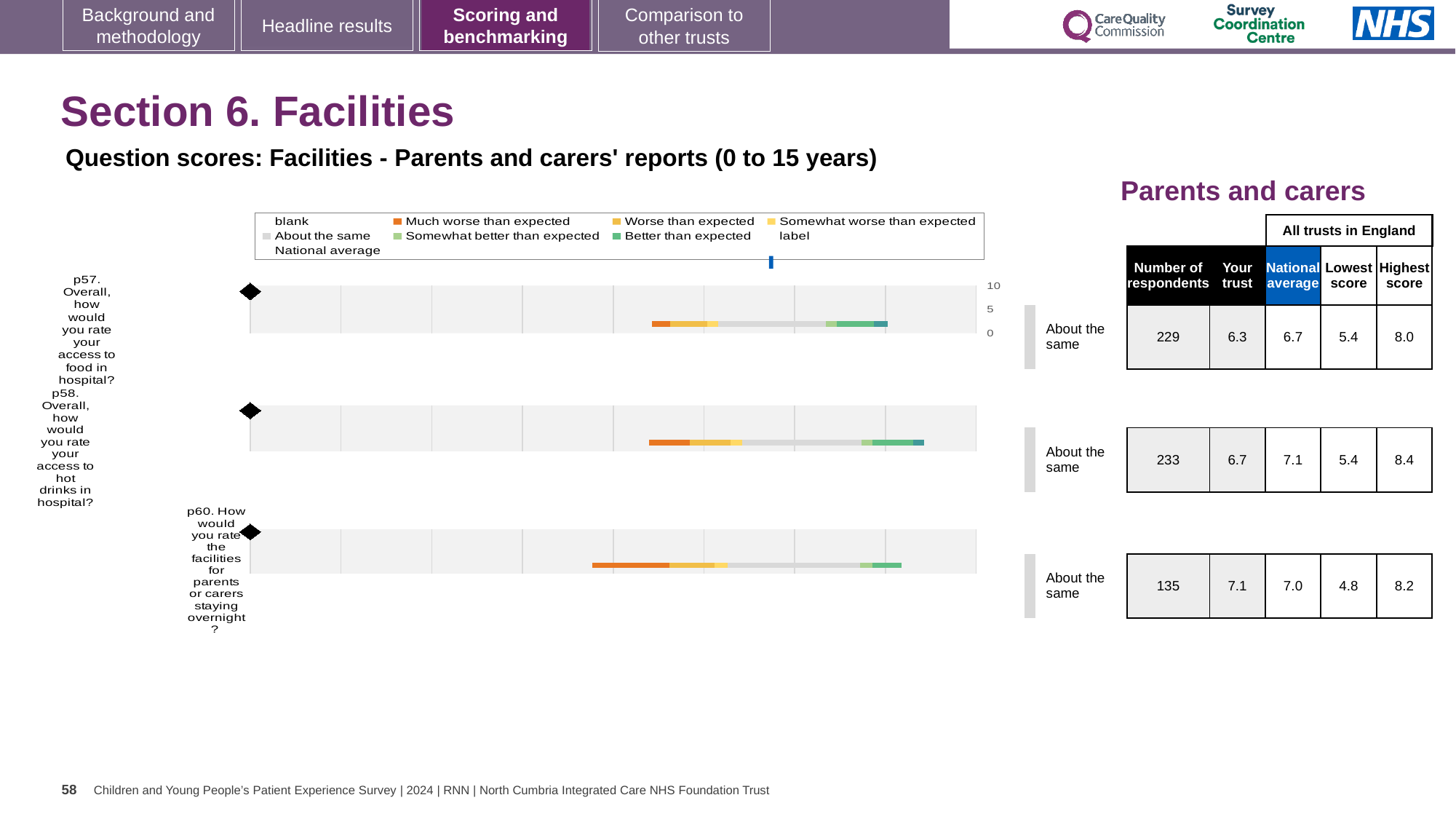
For p60, which is larger: the 'Your trust' score or the national average? Your trust Is the 'Your trust' score for p57 greater or less than 5? greater What is the highest score among all trusts in England for p58? 8.4 Which question has the highest 'Your trust' score? p60 What is the 'Your trust' score for p57 (access to food in hospital)? 6.3 What benchmark category is shown for all three questions in the chart? About the same What is the national average score for p58 (access to hot drinks in hospital)? 7.1 What is the difference between the national average and the 'Your trust' score for p57? 0.4 Which question has the lowest 'Lowest score' among all trusts in England? p60 How many questions (categories) are plotted in the chart? 3 What kind of chart is used to show the question scores on this slide? bar chart How many respondents answered p60 (facilities for parents or carers staying overnight)? 135